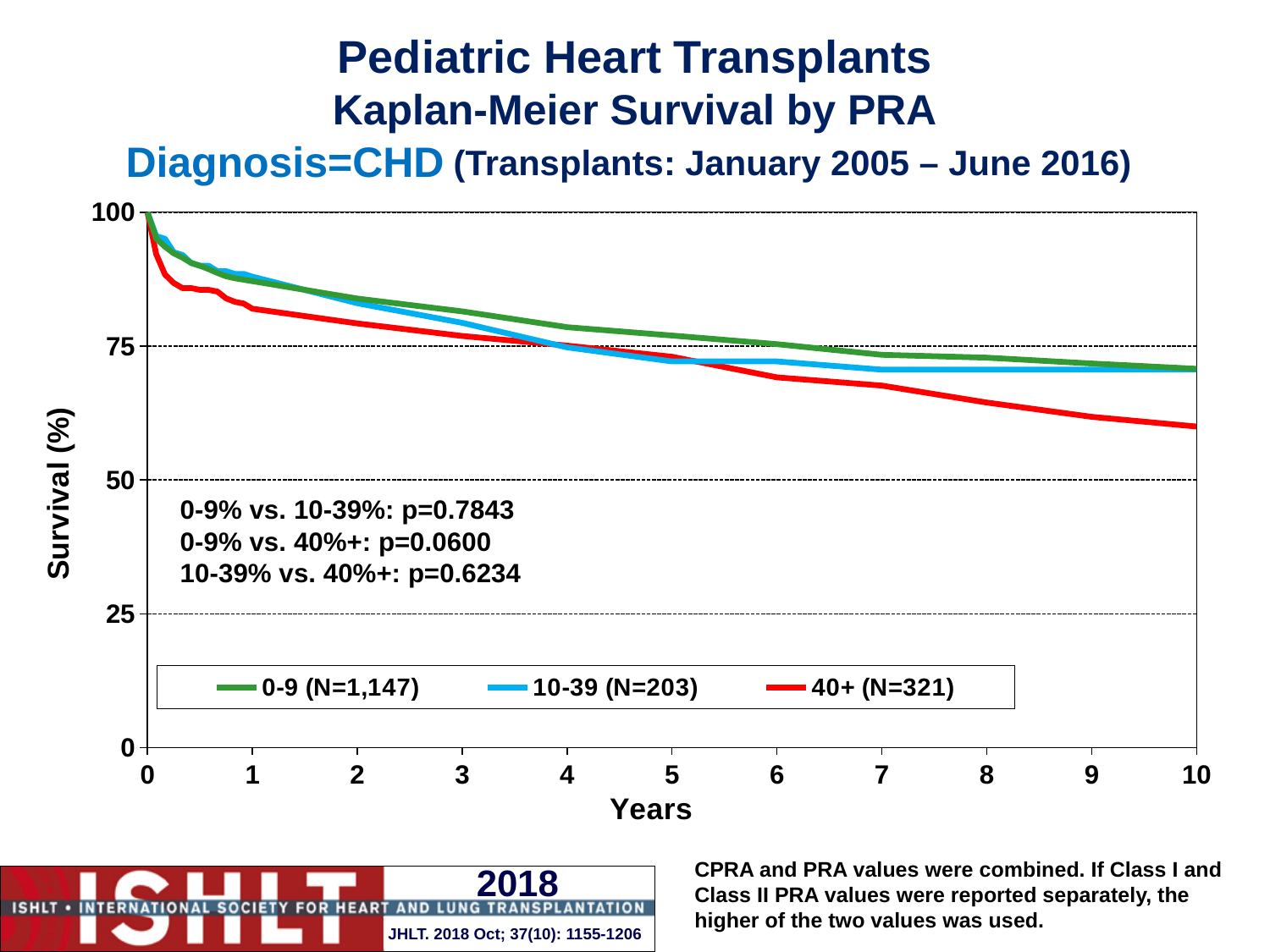
What kind of chart is shown on the slide? Line chart Is the survival for the 0-9 group at 10 years greater or less than 50? greater Is the survival for the 40+ group at 1 year greater or less than 75? greater Which PRA group has the lowest survival at 10 years? 40+ How many series does the legend list? 3 Do the survival curves rise or fall as years increase? Fall At 8 years, which group has higher survival: 10-39 or 40+? 10-39 What is the N for the 0-9 group shown in the legend? 1,147 What p-value is shown for the comparison of 0-9% vs. 40%+? p=0.0600 At 2 years, which group has higher survival: 0-9 or 40+? 0-9 Is the survival for the 40+ group at 10 years greater or less than 75? less